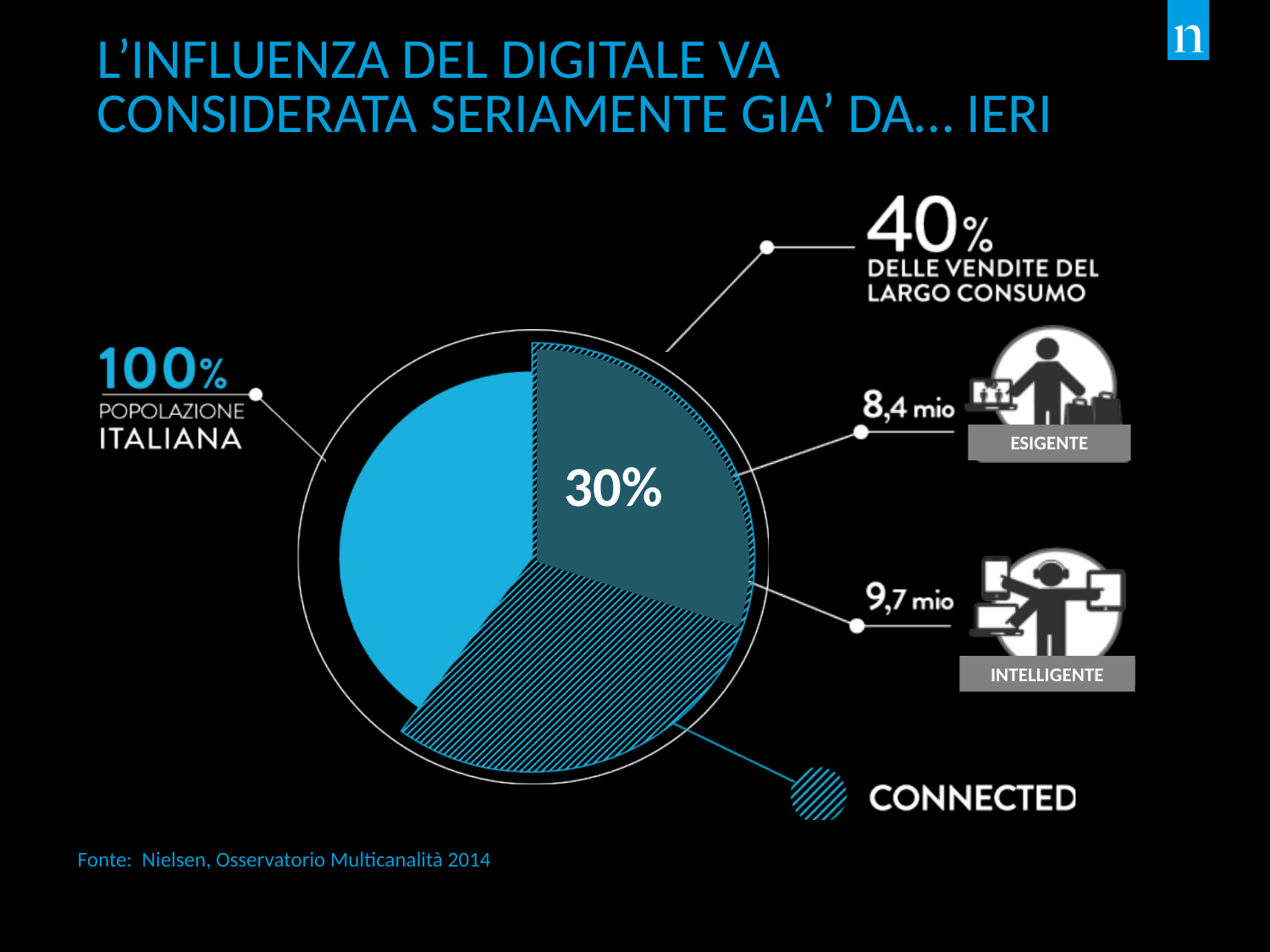
What is the difference between the INTELLIGENTE value and the ESIGENTE value? 1,3 mio What share of sales of 'largo consumo' is attributed to the 30% segment? 40% What label is given to the hatched pattern in the pie chart? CONNECTED What value is shown for the INTELLIGENTE group? 9,7 mio What does the whole pie (100%) represent? Popolazione italiana Which group is larger, ESIGENTE or INTELLIGENTE? INTELLIGENTE What kind of chart is shown on the slide? pie chart What percentage is printed on the dark segment of the pie chart? 30% What value is shown for the ESIGENTE group? 8,4 mio